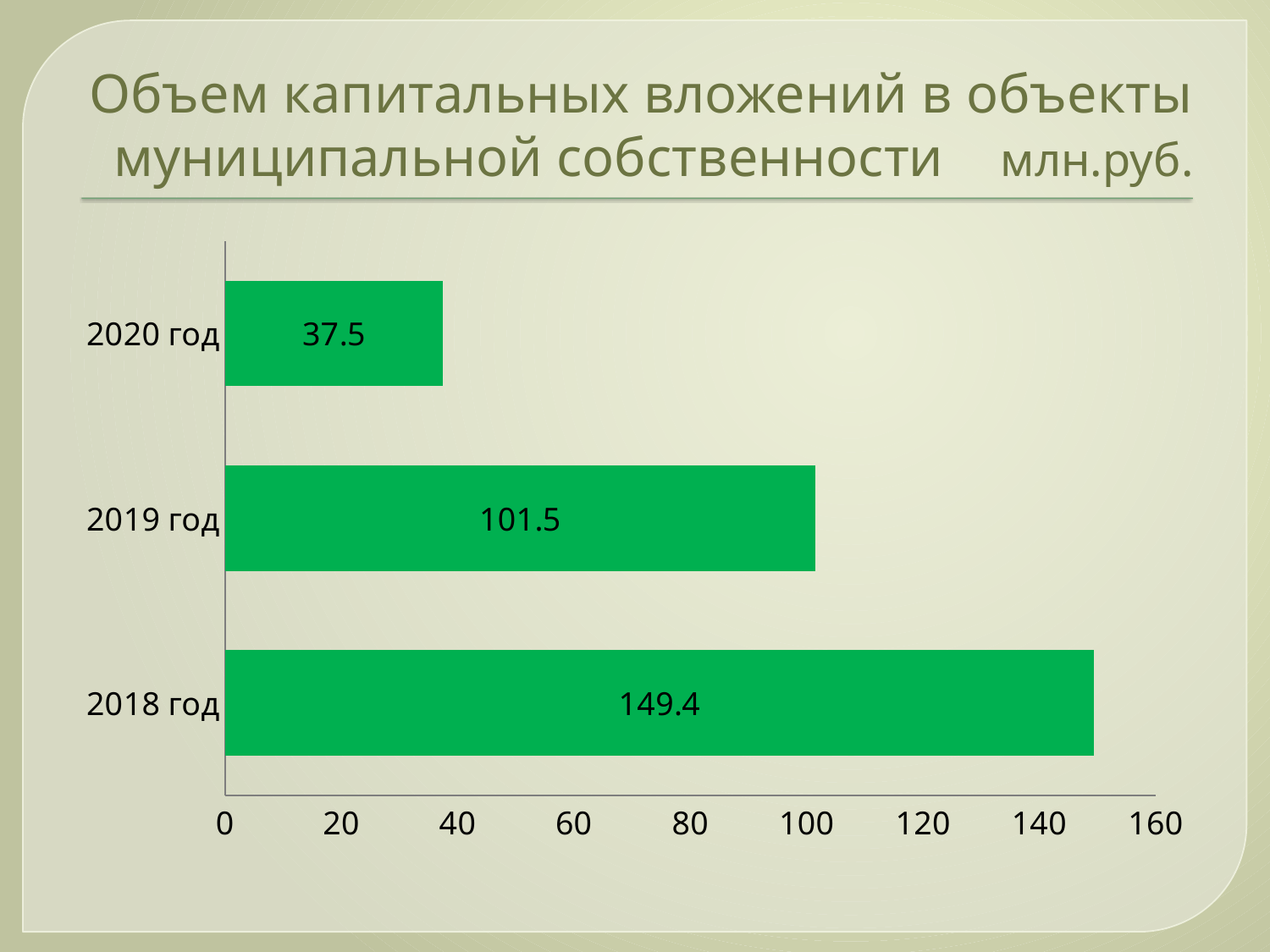
What unit is given in the slide title for the values? млн.руб. Which is larger, the value for 2019 год or the value for 2020 год? 2019 год What is the value for 2020 год? 37.5 What is the value for 2018 год? 149.4 Which year has the highest value? 2018 год What kind of chart is shown on the slide? bar chart What is the value for 2019 год? 101.5 Is the value for 2018 год greater or less than 140? greater How many years are shown in the chart? 3 What is the difference between the values for 2019 год and 2020 год? 64 Which year has the lowest value? 2020 год What is the difference between the values for 2018 год and 2019 год? 47.9